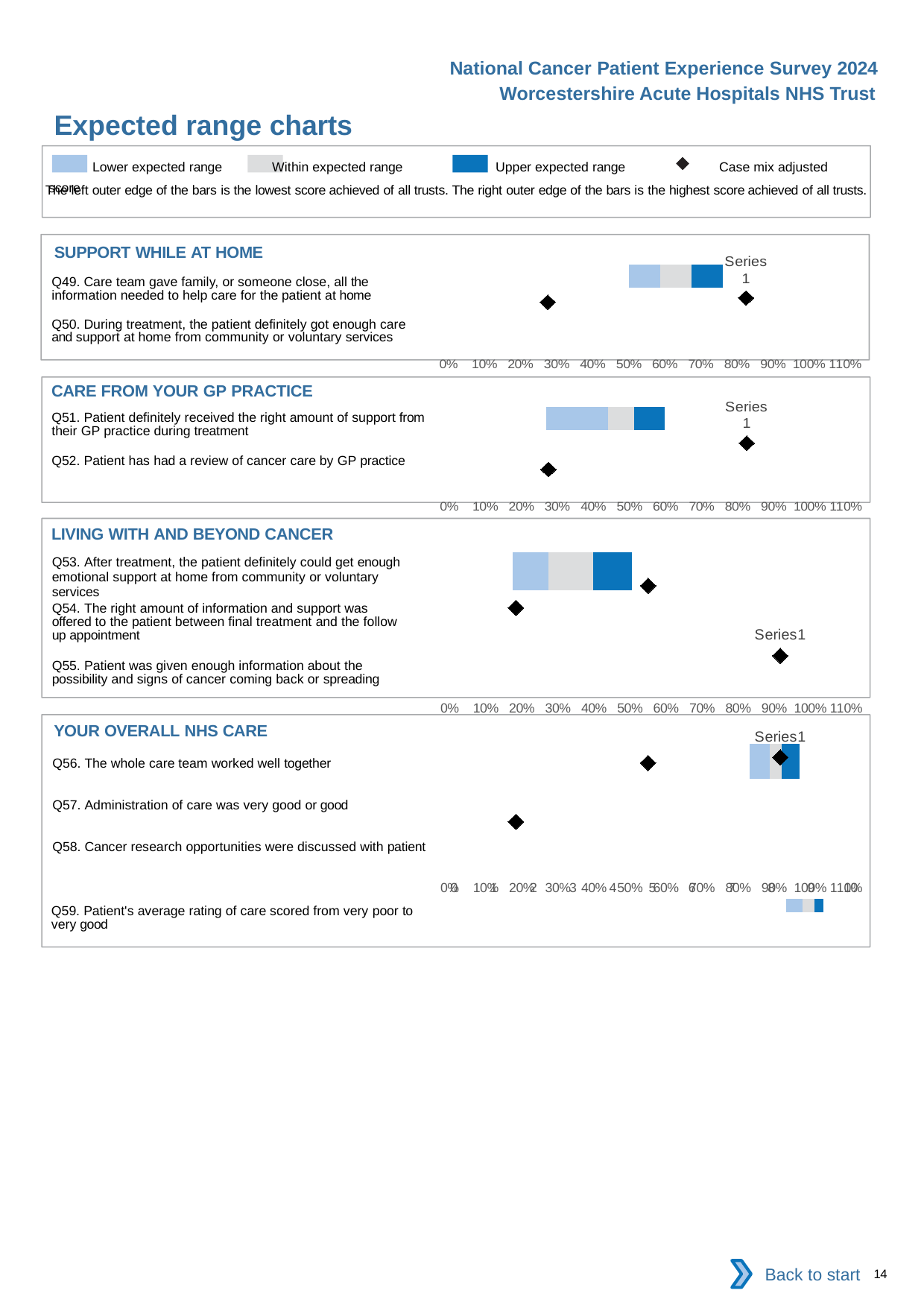
What kind of chart is used in the 'SUPPORT WHILE AT HOME' section? bar chart How many questions are listed in the 'LIVING WITH AND BEYOND CANCER' section? 3 What does the diamond marker in the legend represent? Case mix adjusted score How many questions are listed in the 'YOUR OVERALL NHS CARE' section? 4 What is the highest tick label shown on the x axis of the 'CARE FROM YOUR GP PRACTICE' chart? 110% In the 'CARE FROM YOUR GP PRACTICE' chart, is the left edge of the expected range bar for Q51 greater or less than 40%? less How many questions are listed in the 'SUPPORT WHILE AT HOME' section? 2 In the 'SUPPORT WHILE AT HOME' chart, is the right edge of the expected range bar greater or less than 70%? greater How many entries does the legend at the top of the slide list? 4 In the 'YOUR OVERALL NHS CARE' chart, is the diamond marker aligned with Q56 greater or less than 40%? greater